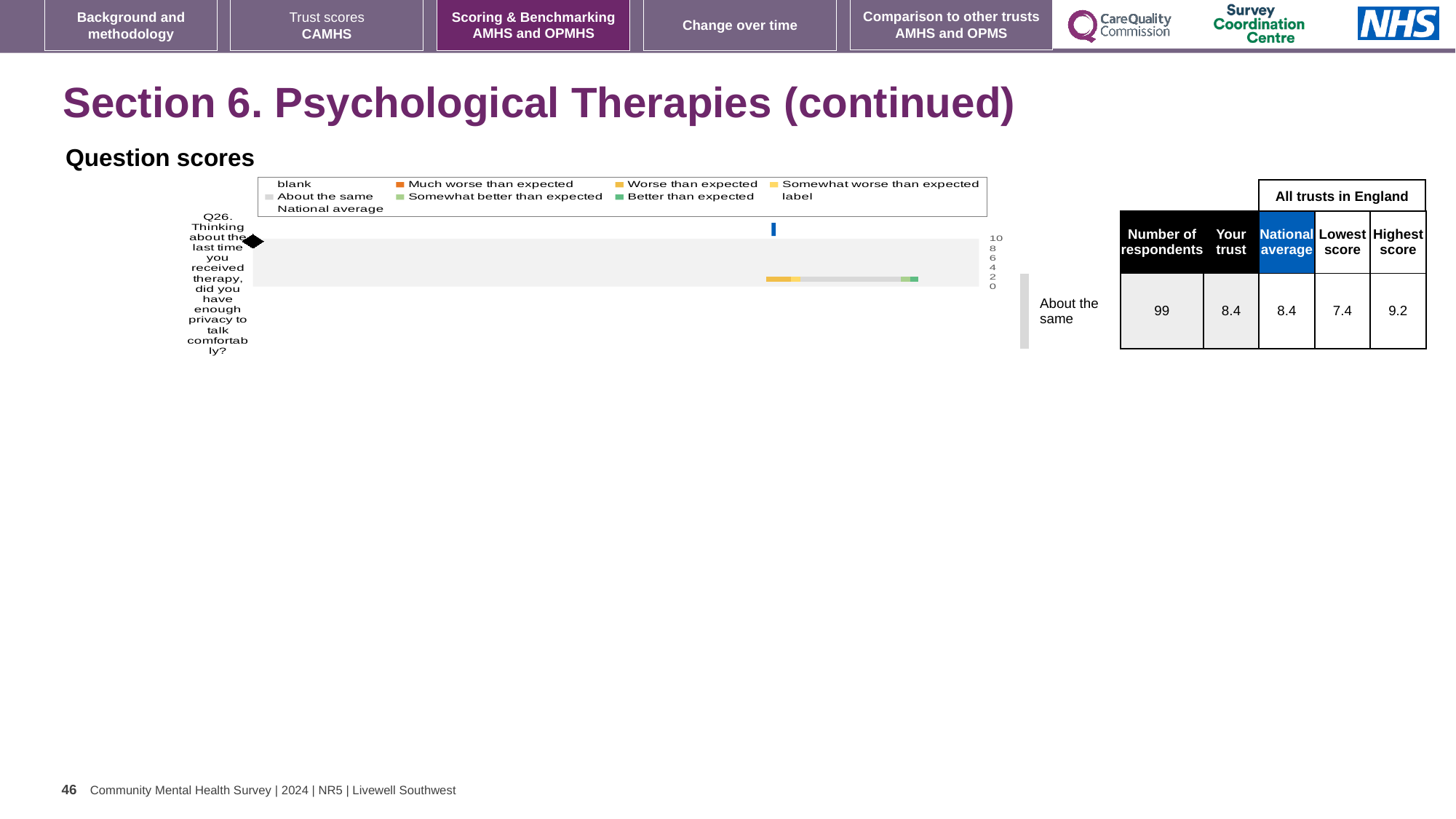
How many survey questions are plotted in the chart? 1 Which benchmark category is the trust's Q26 result placed in, as labelled next to the chart? About the same In the table beside the chart, what is the 'Your trust' score for Q26? 8.4 In the table beside the chart, what is the national average score for Q26? 8.4 What is the difference between the highest score and the lowest score for Q26 in the table? 1.8 In the table beside the chart, what is the highest score among all trusts in England for Q26? 9.2 How many entries does the chart legend list? 9 In the table beside the chart, how many respondents answered Q26? 99 In the table beside the chart, what is the lowest score among all trusts in England for Q26? 7.4 What kind of chart is shown under 'Question scores'? bar chart Which legend entry is shown in orange? Much worse than expected